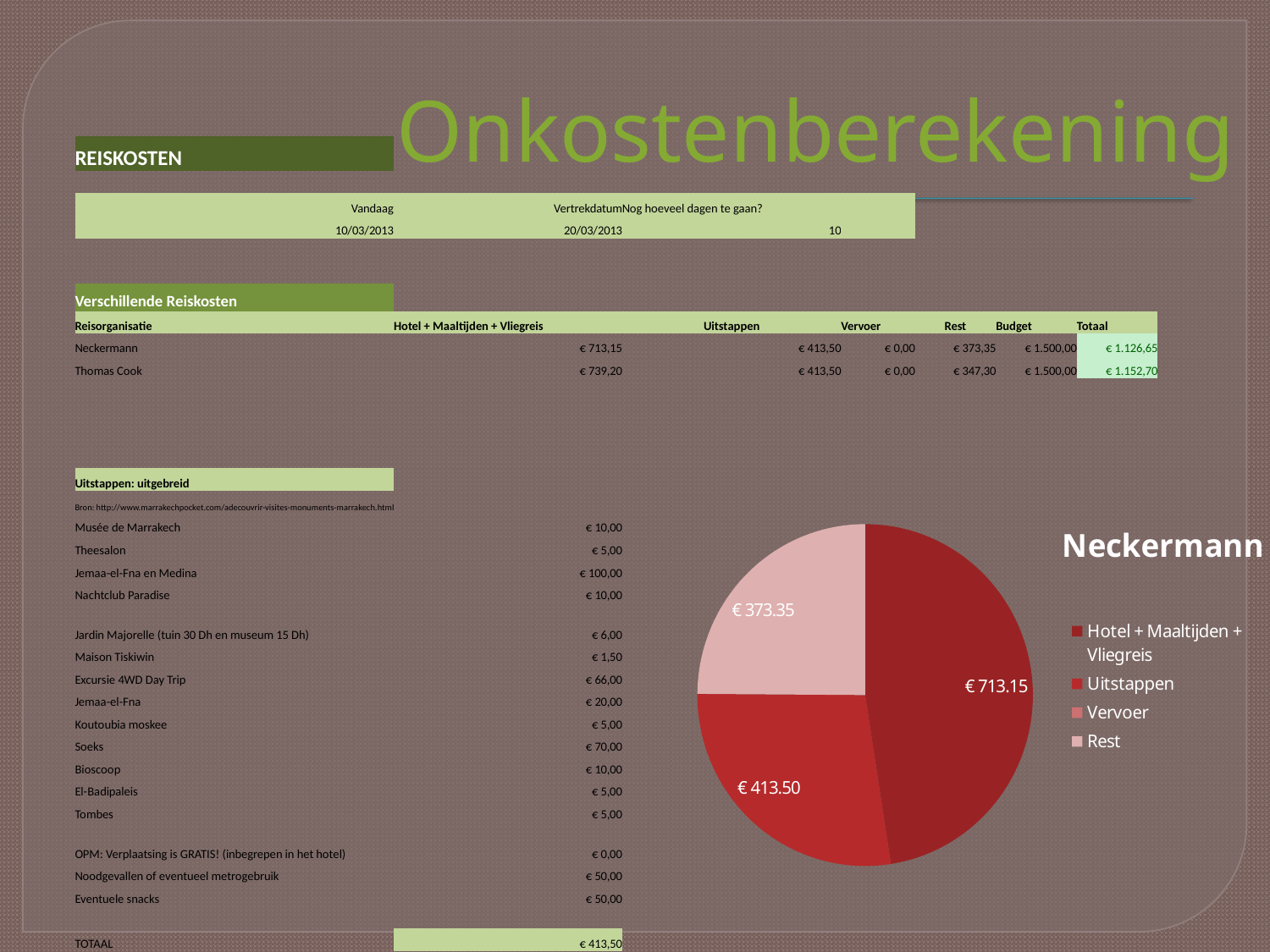
In the pie chart, what is the value for Hotel + Maaltijden + Vliegreis? € 713.15 What kind of chart is shown on the slide? pie chart What is the difference between the Uitstappen value and the Rest value in the pie chart? € 40.15 In the pie chart, which is larger: Uitstappen or Rest? Uitstappen How many data labels are printed on the pie chart? 3 What is the title of the pie chart? Neckermann In the pie chart, what is the value for Rest? € 373.35 Of the three labelled slices in the pie chart, which is the smallest? Rest In the pie chart, what is the value for Uitstappen? € 413.50 Which category has the largest slice in the pie chart? Hotel + Maaltijden + Vliegreis What is the difference between the Hotel + Maaltijden + Vliegreis value and the Uitstappen value in the pie chart? € 299.65 How many entries does the legend of the pie chart list? 4